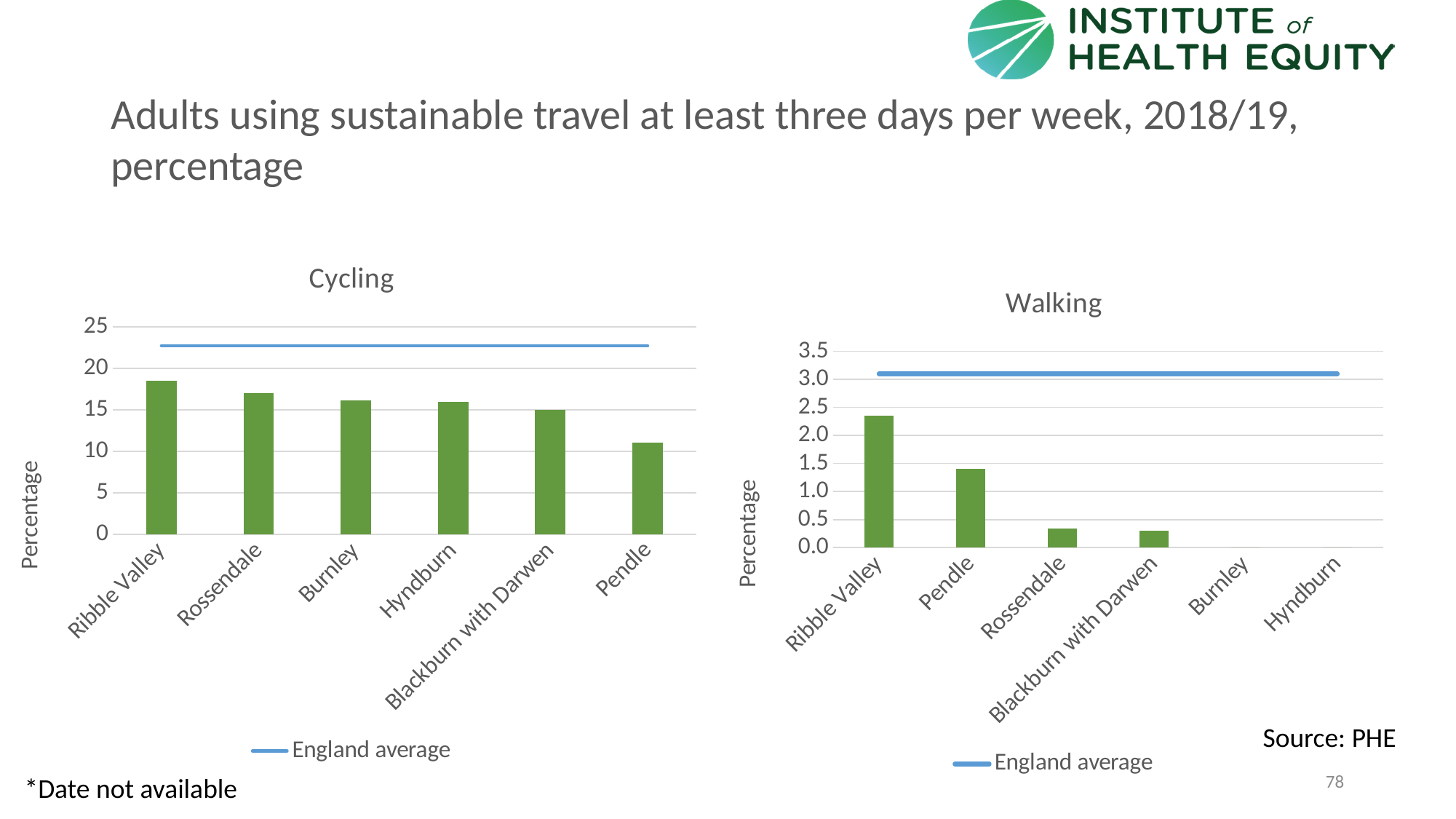
What type of chart is the Cycling chart? bar chart In the Cycling chart, is the value for Pendle greater or less than 15? less In the Walking chart, is the value for Pendle greater or less than 1.5? less In the Walking chart, which is larger, the value for Pendle or the value for Rossendale? Pendle In the Cycling chart, is the England average line above or below 20? above In the Cycling chart, which area has the lowest percentage? Pendle In the Cycling chart, how many areas are shown on the x axis? 6 In the Cycling chart, which area has the highest percentage? Ribble Valley What does the blue horizontal line in each chart represent, according to the legend? England average In the Walking chart, which area has the highest percentage? Ribble Valley